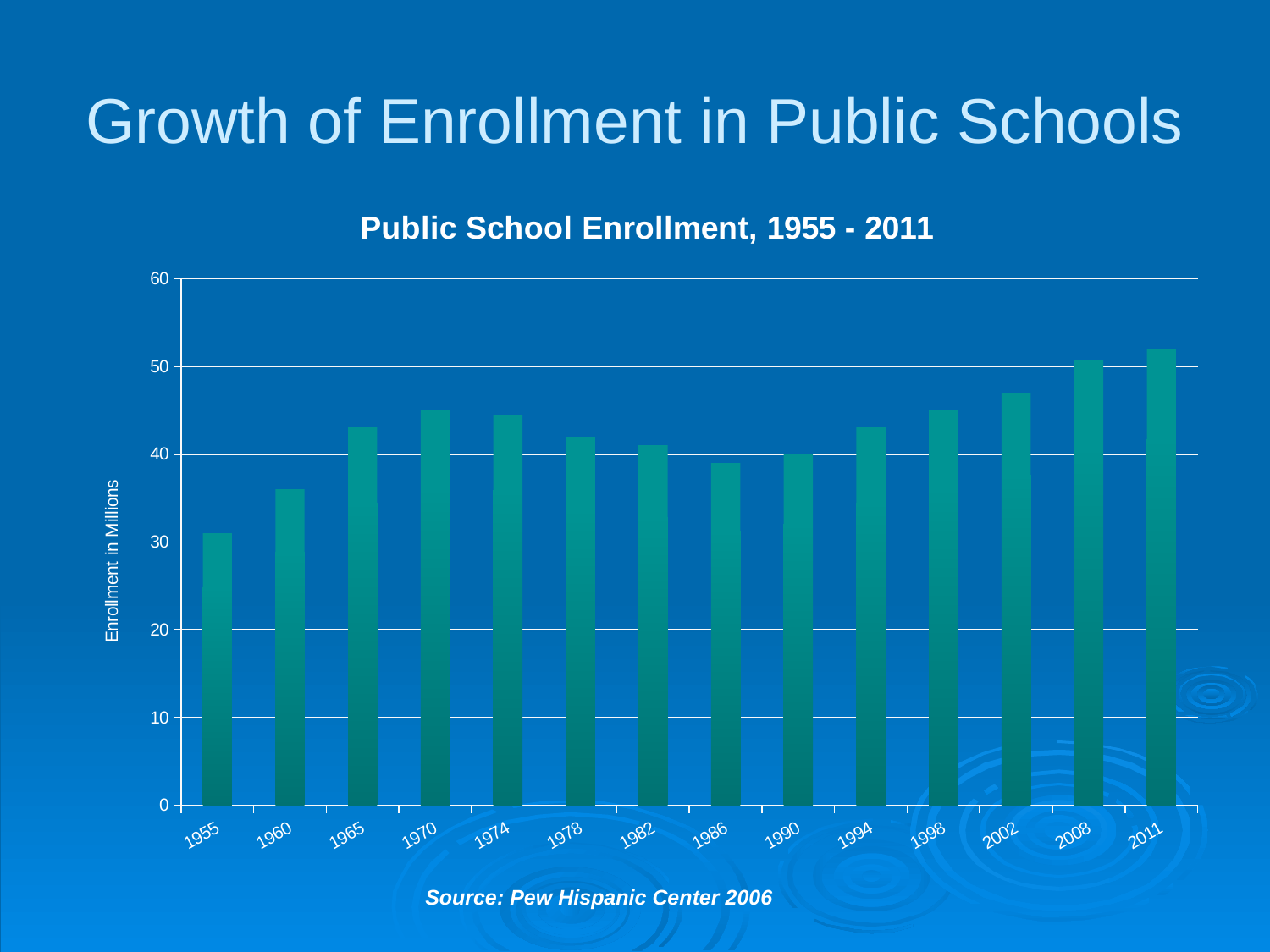
Which is larger, the enrollment in 1986 or in 2002? 2002 Is the value for 2011 greater or less than 50? greater Between 1970 and 1986, do the enrollment values rise or fall? fall Is the value for 1955 greater or less than 40? less What kind of chart is shown on the slide? bar chart Which is larger, the enrollment in 1960 or in 1965? 1965 Is the value for 1986 greater or less than 40? less Which year has the lowest public school enrollment? 1955 What is the label on the vertical axis of the chart? Enrollment in Millions Which year has the highest public school enrollment? 2011 How many years are plotted on the x axis of the chart? 14